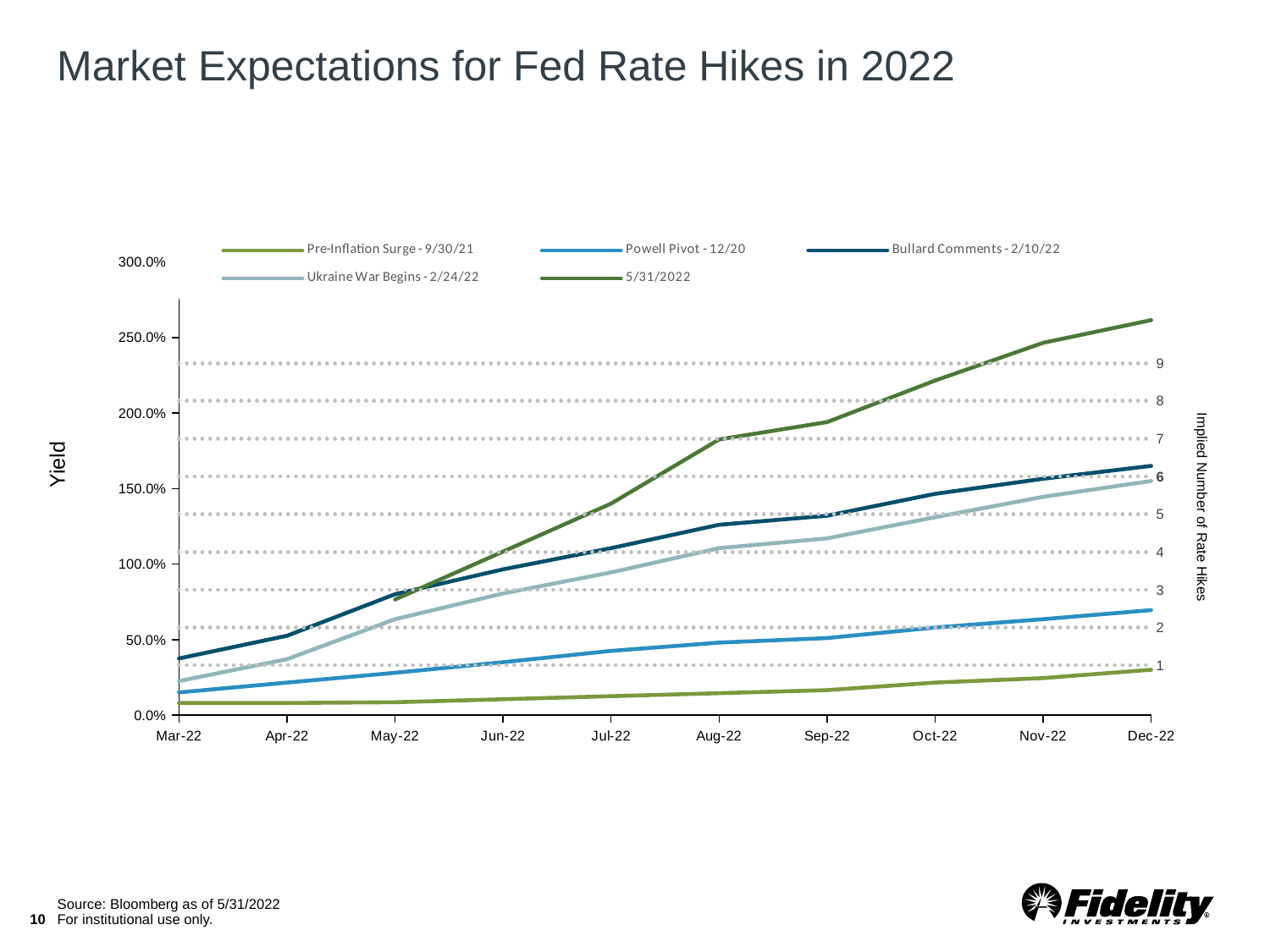
Is the value of the 5/31/2022 series at Dec-22 greater or less than 250.0%? greater How many series does the legend list? 5 Which series has the lowest value at Dec-22? Pre-Inflation Surge - 9/30/21 Is the value of the Bullard Comments - 2/10/22 series at Dec-22 greater or less than 150.0%? greater How many months are labelled along the x axis? 10 Which series has the highest value at Dec-22? 5/31/2022 Is the value of the Pre-Inflation Surge - 9/30/21 series at Dec-22 greater or less than 50.0%? less What kind of chart is shown on the slide? Line chart At Dec-22, which is larger: the Powell Pivot - 12/20 series or the Pre-Inflation Surge - 9/30/21 series? Powell Pivot - 12/20 What is the label of the right-hand vertical axis? Implied Number of Rate Hikes Do the values of the 5/31/2022 series rise or fall from Mar-22 to Dec-22? Rise